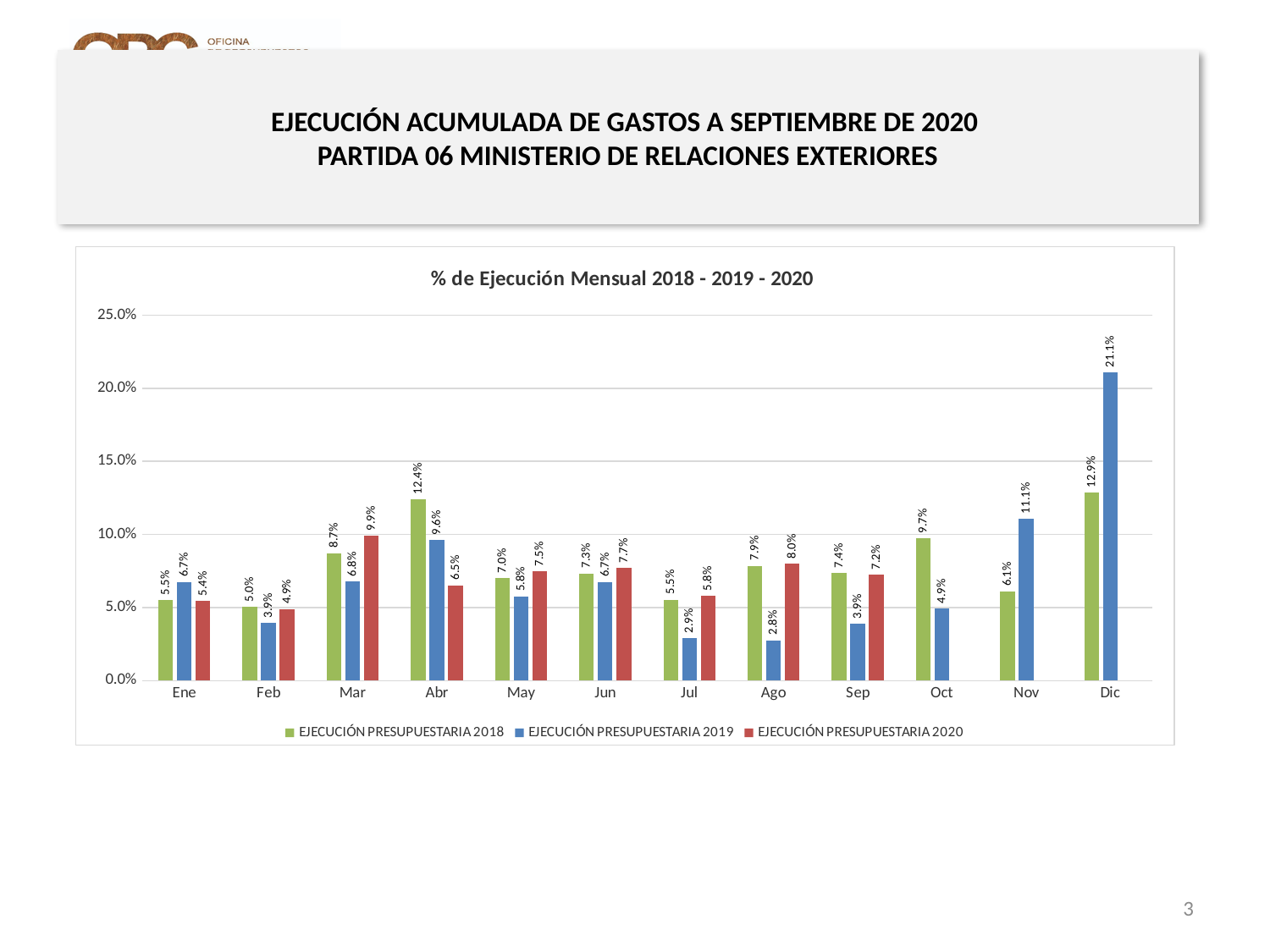
Which is larger in Abr: EJECUCIÓN PRESUPUESTARIA 2018 or EJECUCIÓN PRESUPUESTARIA 2020? EJECUCIÓN PRESUPUESTARIA 2018 What is the difference between EJECUCIÓN PRESUPUESTARIA 2019 and EJECUCIÓN PRESUPUESTARIA 2018 in Dic? 8.2% What kind of chart is shown? Bar chart What is the value for EJECUCIÓN PRESUPUESTARIA 2018 in Abr? 12.4% How many series does the legend list? 3 What is the value for EJECUCIÓN PRESUPUESTARIA 2020 in Mar? 9.9% What is the title of the chart? % de Ejecución Mensual 2018 - 2019 - 2020 Is the value for EJECUCIÓN PRESUPUESTARIA 2019 in Nov greater or less than 10.0%? greater How many months are shown on the x axis? 12 What is the value for EJECUCIÓN PRESUPUESTARIA 2019 in Dic? 21.1% Which month has the highest value for EJECUCIÓN PRESUPUESTARIA 2018? Dic Which month has the lowest value for EJECUCIÓN PRESUPUESTARIA 2019? Ago